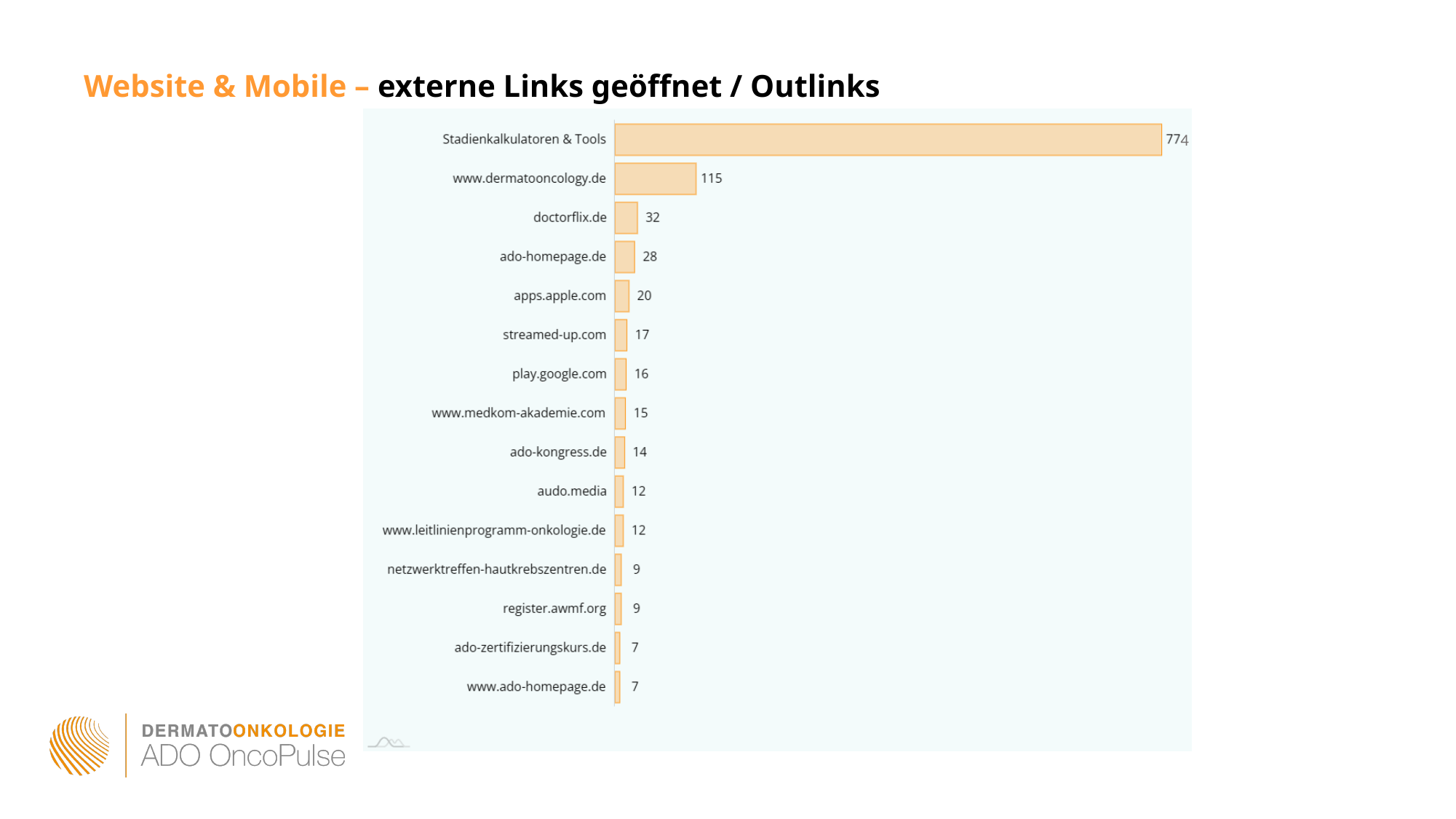
What is the value for register.awmf.org? 9 What is the value for Stadienkalkulatoren & Tools? 774 Which is larger, the value for streamed-up.com or the value for play.google.com? streamed-up.com What is the value for www.medkom-akademie.com? 15 What kind of chart is shown on the slide? bar chart What is the value for apps.apple.com? 20 How many categories are shown in the chart? 15 What is the value for doctorflix.de? 32 What is the value for www.dermatooncology.de? 115 What is the difference between the values for Stadienkalkulatoren & Tools and www.dermatooncology.de? 659 Which category has the highest value? Stadienkalkulatoren & Tools What is the difference between the values for doctorflix.de and ado-homepage.de? 4